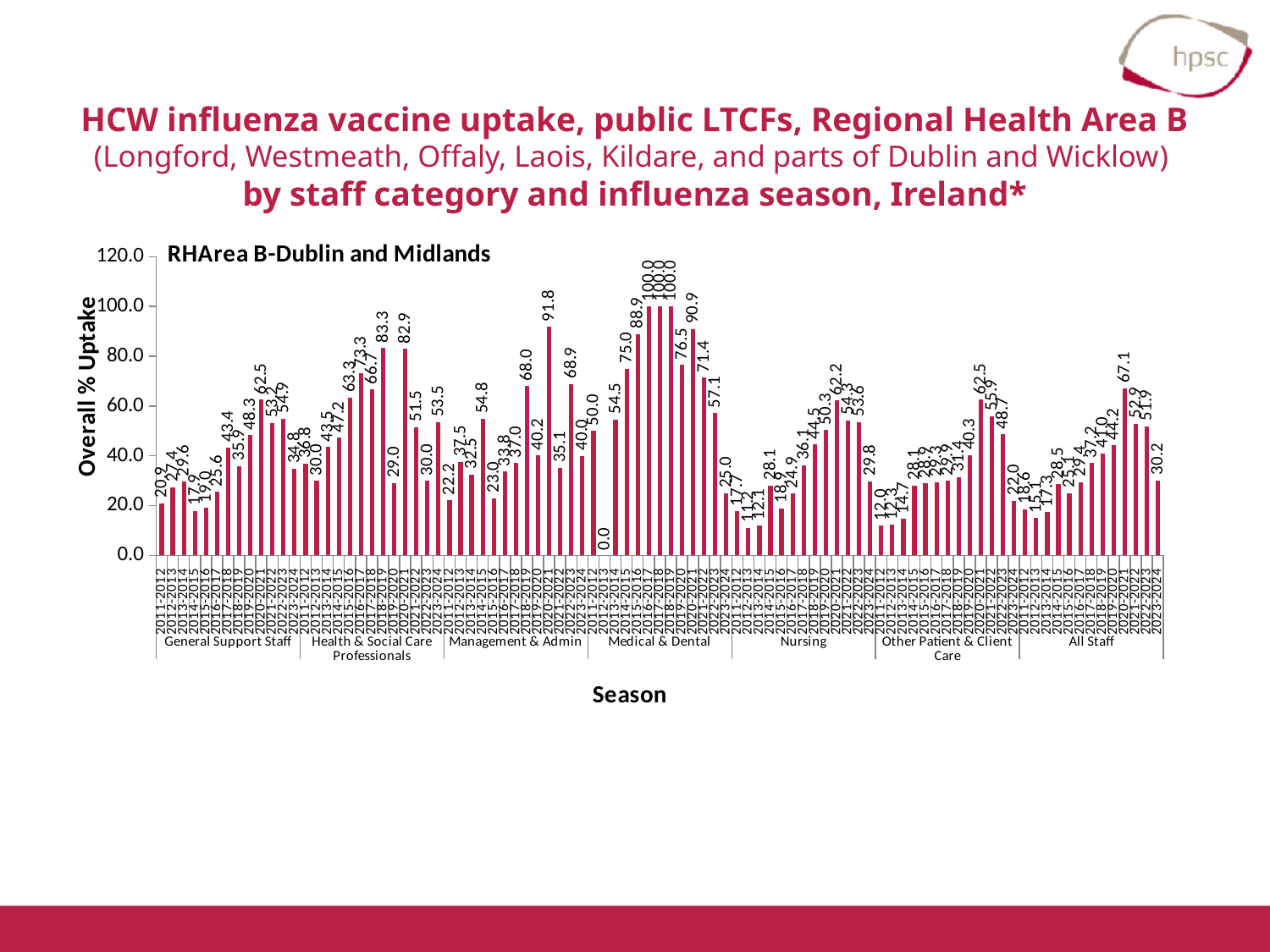
What is the difference between the All Staff peak value of 67.1 and the All Staff 2023-2024 value of 30.2? 36.9 What is the highest uptake value in the All Staff group? 67.1 What is the uptake value for General Support Staff in the 2011-2012 season? 20.9 What is the highest uptake value in the Management & Admin group? 91.8 How many influenza seasons are plotted for each staff category? 13 What is the title printed inside the chart area? RHArea B-Dublin and Midlands How many staff categories are shown along the x axis of the chart? 7 What is the label on the vertical axis of the chart? Overall % Uptake What is the highest value reached by any bar in the chart, and in which staff category does it occur? 100.0, Medical & Dental What kind of chart is shown on the slide? Bar chart What is the lowest value shown in the chart, and for which staff category and season? 0.0, Medical & Dental, 2012-2013 What is the uptake value for All Staff in the 2023-2024 season? 30.2